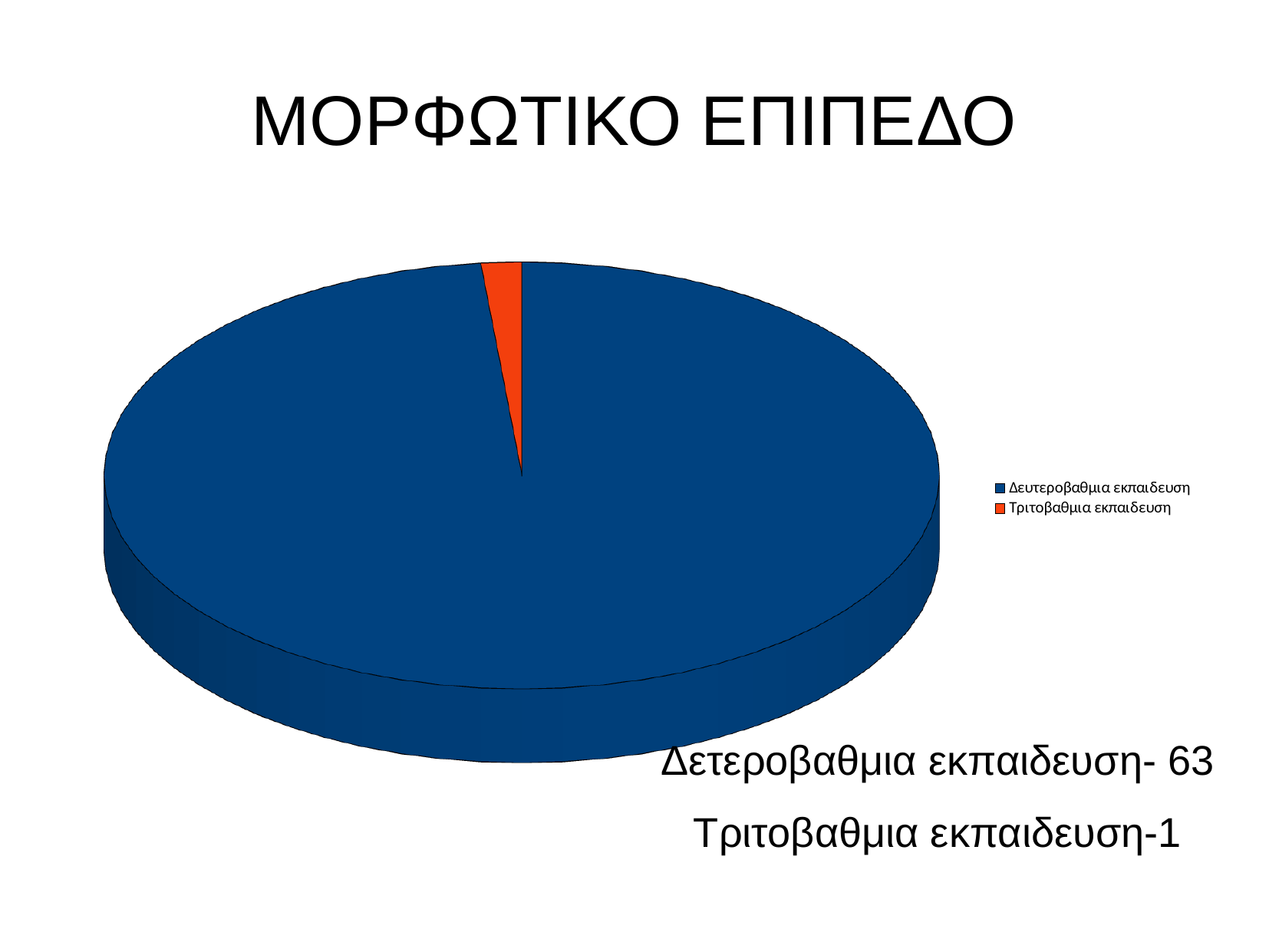
What kind of chart is shown on the slide? pie chart What is the total of the two values shown for the pie chart? 64 What value is given for Τριτοβαθμια εκπαιδευση? 1 Which is larger, the value for Δευτεροβαθμια εκπαιδευση or for Τριτοβαθμια εκπαιδευση? Δευτεροβαθμια εκπαιδευση Which category has the largest slice of the pie? Δευτεροβαθμια εκπαιδευση What colour is the slice for Τριτοβαθμια εκπαιδευση? orange What is the title of the chart on the slide? ΜΟΡΦΩΤΙΚΟ ΕΠΙΠΕΔΟ Which category has the smallest slice of the pie? Τριτοβαθμια εκπαιδευση What is the difference between the values for Δευτεροβαθμια εκπαιδευση and Τριτοβαθμια εκπαιδευση? 62 How many entries does the legend list? 2 How many slices does the pie chart have? 2 What value is given for Δευτεροβαθμια εκπαιδευση? 63